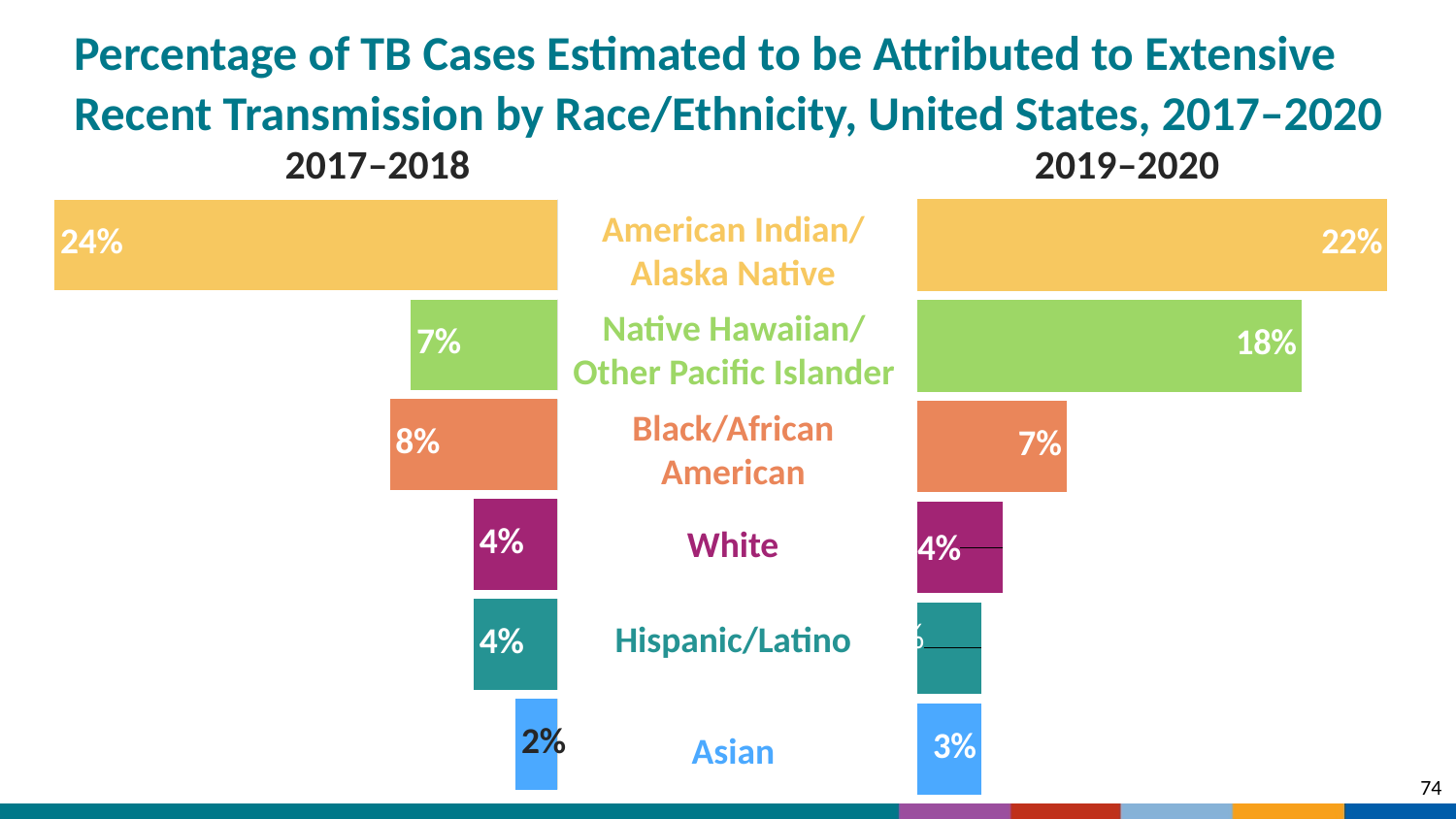
In the 2017–2018 chart, what percentage of TB cases is attributed to extensive recent transmission for American Indian/Alaska Native? 24% In the 2019–2020 chart, what is the value for Asian? 3% In the 2019–2020 chart, which race/ethnicity has the highest percentage? American Indian/Alaska Native What colour are the bars for the White category? Purple How many race/ethnicity categories are shown on the slide? 6 In the 2017–2018 chart, which race/ethnicity has the lowest percentage? Asian What kind of chart is shown on the slide? Bar chart For Black/African American, which period has the larger value, 2017–2018 or 2019–2020? 2017–2018 In the 2019–2020 chart, what is the value for Native Hawaiian/Other Pacific Islander? 18% In the 2017–2018 chart, what is the value for Black/African American? 8% In the 2017–2018 chart, which race/ethnicity has the highest percentage? American Indian/Alaska Native What is the difference between the Native Hawaiian/Other Pacific Islander values in 2019–2020 and 2017–2018? 11%